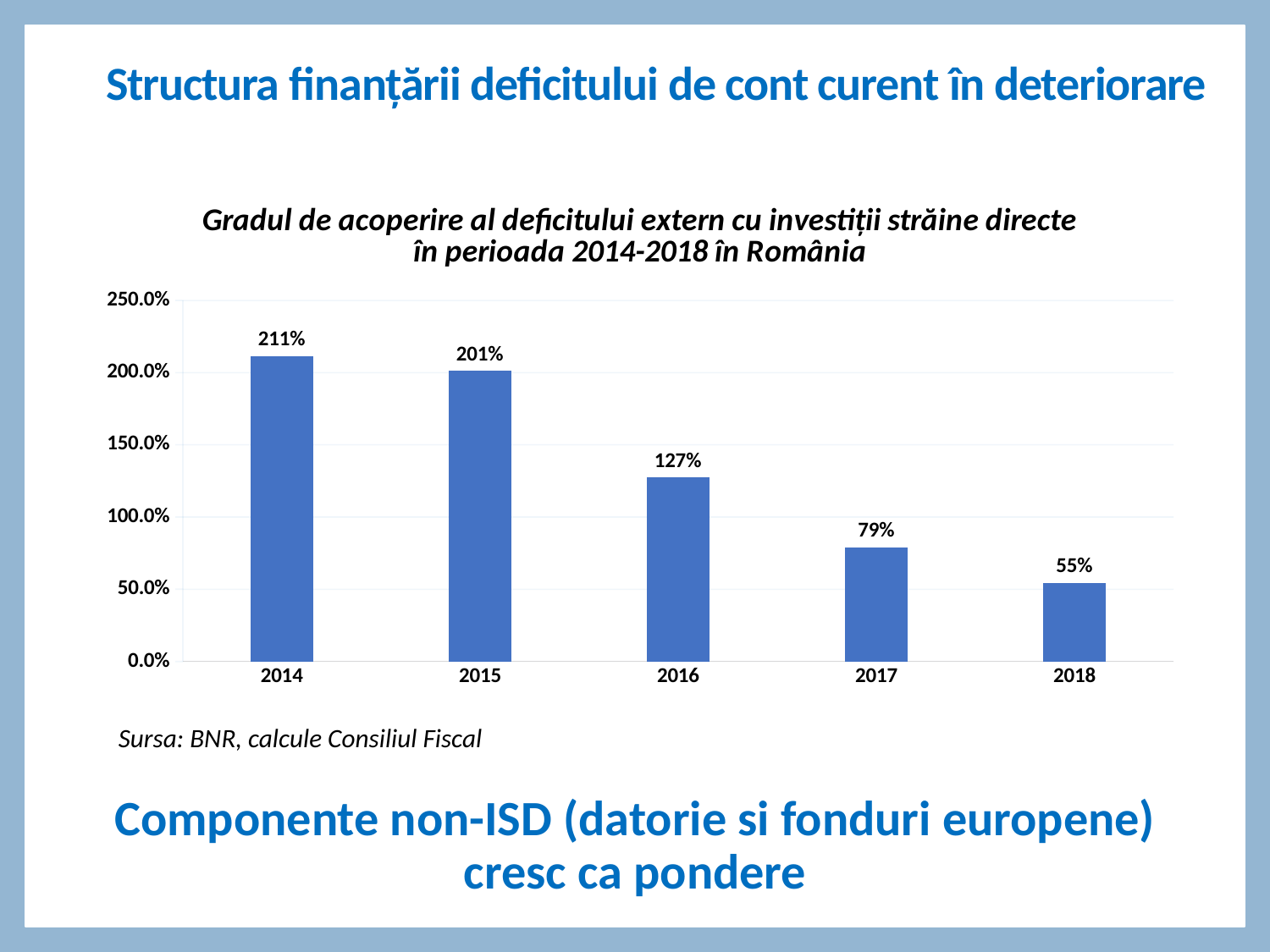
Do the values rise or fall from 2014 to 2018? fall Which is larger, the value for 2015 or the value for 2017? 2015 What is the value for 2018? 55% What is the value for 2016? 127% What is the difference between the values for 2016 and 2017? 48% What kind of chart is shown on the slide? bar chart How many years are shown on the x axis? 5 Which year has the lowest value? 2018 What is the value for 2014? 211% Which year has the highest value? 2014 Is the value for 2017 greater or less than 100.0%? less What is the difference between the values for 2014 and 2015? 10%